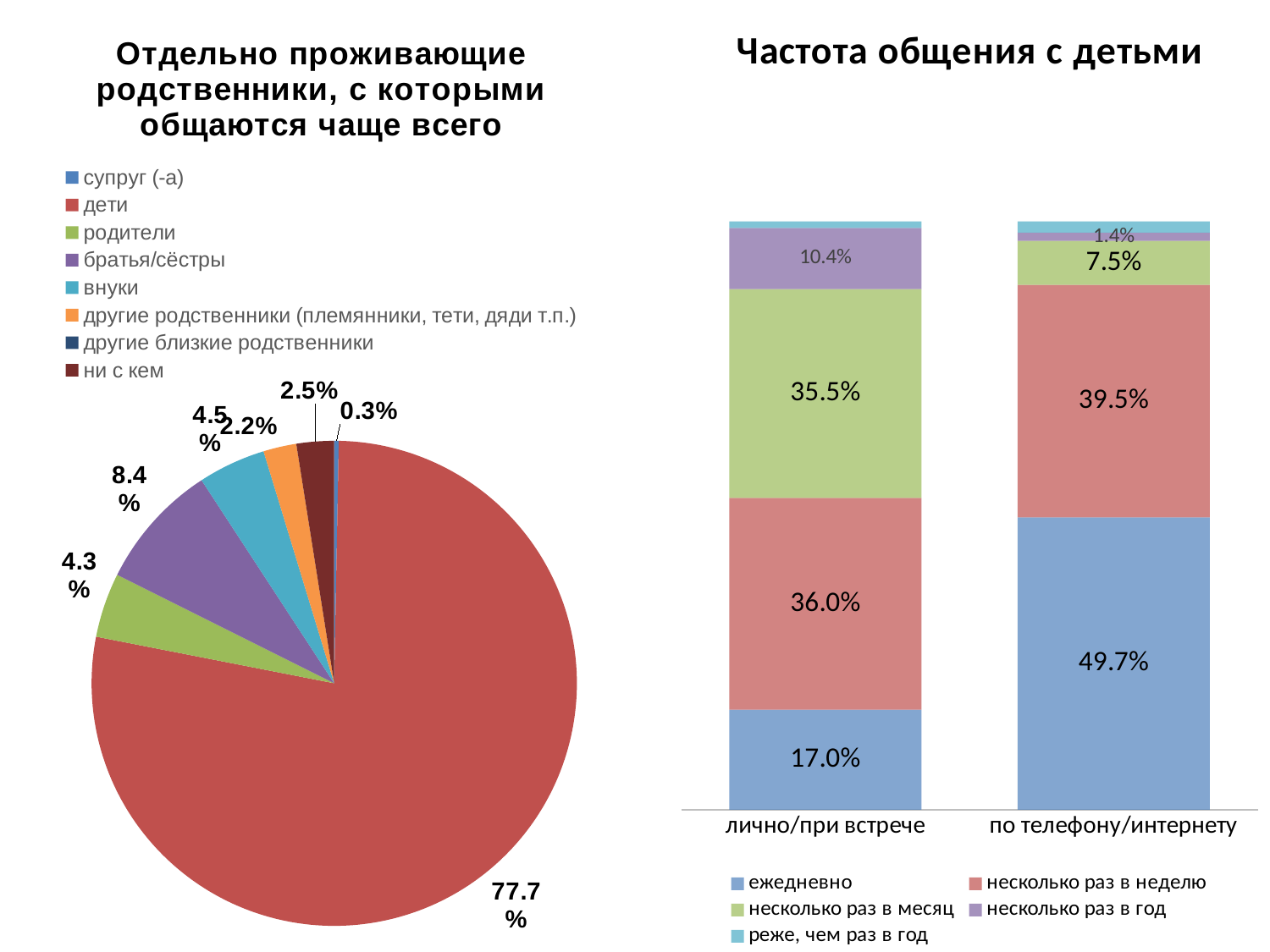
In the chart 'Частота общения с детьми', which bar has the larger value for 'несколько раз в месяц': 'лично/при встрече' or 'по телефону/интернету'? лично/при встрече How many series does the legend of the chart 'Частота общения с детьми' list? 5 What kind of chart is the right chart titled 'Частота общения с детьми'? Stacked bar chart In the chart 'Частота общения с детьми', what is the value for 'ежедневно' in the 'лично/при встрече' bar? 17.0% In the pie chart on the left, what is the difference between the values for 'братья/сёстры' and 'родители'? 4.1 percentage points In the pie chart on the left, which category has the largest slice? дети In the chart 'Частота общения с детьми', what is the value for 'несколько раз в неделю' in the 'по телефону/интернету' bar? 39.5% In the pie chart on the left, what share of the pie does 'дети' take? 77.7% In the pie chart on the left, what is the value for 'братья/сёстры'? 8.4% In the chart 'Частота общения с детьми', what is the difference between the 'ежедневно' values for 'по телефону/интернету' and 'лично/при встрече'? 32.7 percentage points What kind of chart is the left chart titled 'Отдельно проживающие родственники, с которыми общаются чаще всего'? Pie chart How many entries does the legend of the pie chart on the left list? 8